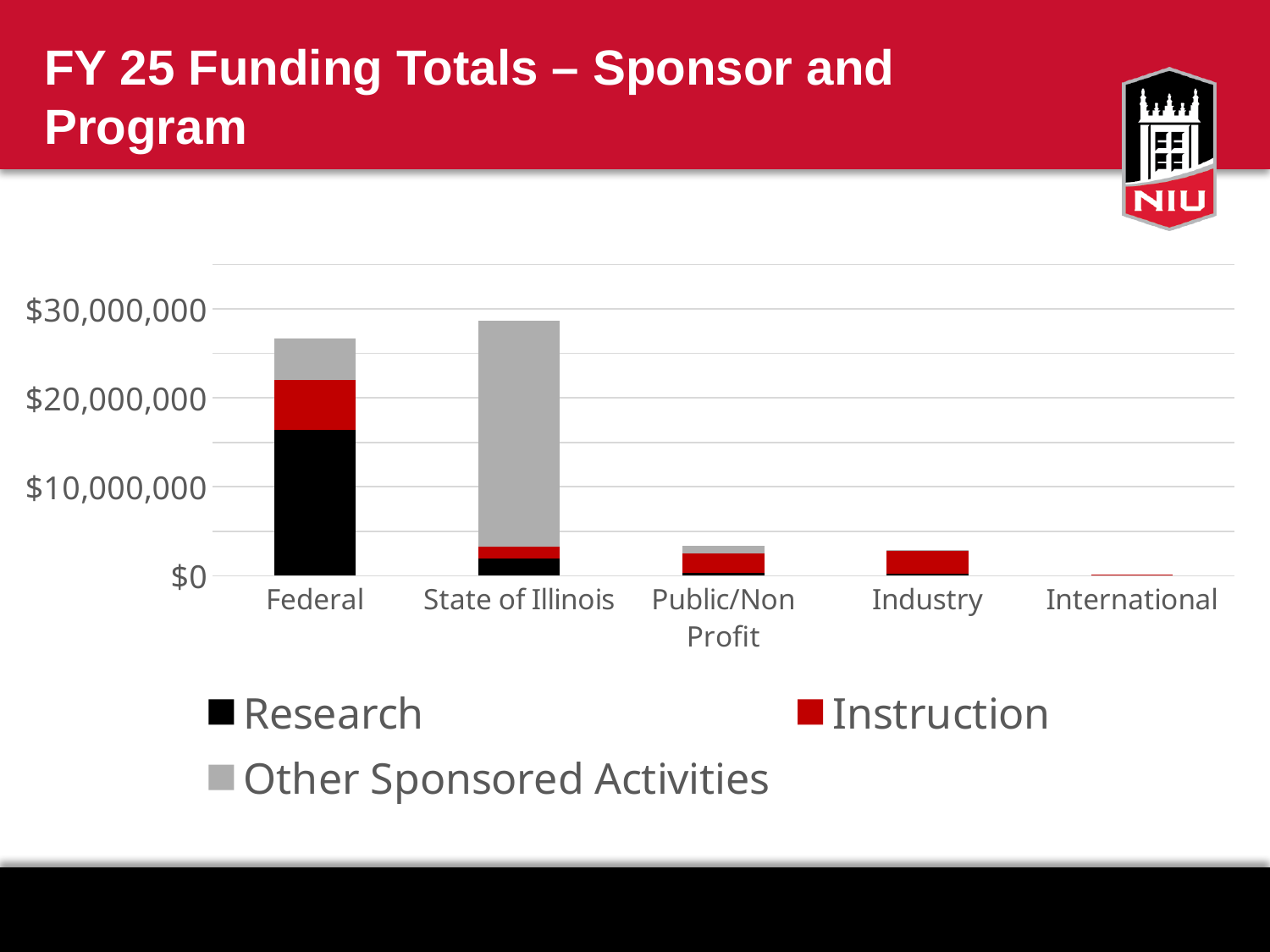
Is the Research portion of the Federal bar greater or less than $10,000,000? greater Which sponsor category has the tallest stacked bar overall? State of Illinois Is the total funding for State of Illinois greater or less than $30,000,000? less Is the total funding for Federal greater or less than $20,000,000? greater How many series does the legend list? 3 Which sponsor category has the smallest total funding? International Which series makes up the largest part of the State of Illinois bar? Other Sponsored Activities Which has a larger total funding, Federal or Industry? Federal What kind of chart is shown on the slide? Stacked bar chart How many sponsor categories are shown on the x axis? 5 What colour represents the Instruction series in the legend? Red